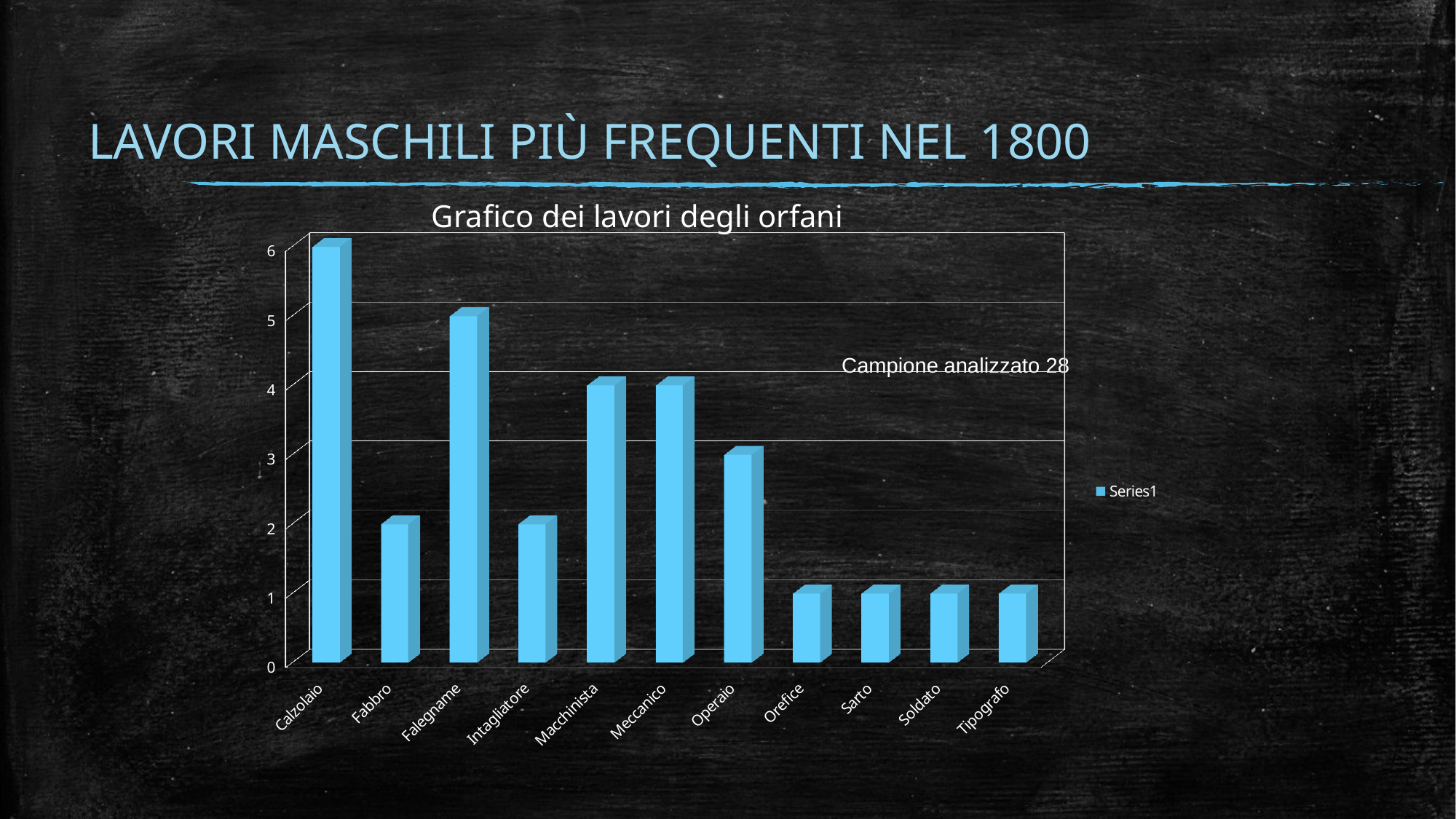
What is the value for Operaio? 3 How many categories are shown on the x axis of the chart? 11 How many series does the legend list? 1 Which is larger, the value for Macchinista or the value for Intagliatore? Macchinista What kind of chart is shown on the slide? bar chart Is the value for Falegname greater or less than 4? greater What is the title of the chart? Grafico dei lavori degli orfani Which category has the highest value? Calzolaio What is the value for Falegname? 5 What is the value for Calzolaio? 6 What is the value for Sarto? 1 What is the difference between the values for Calzolaio and Fabbro? 4